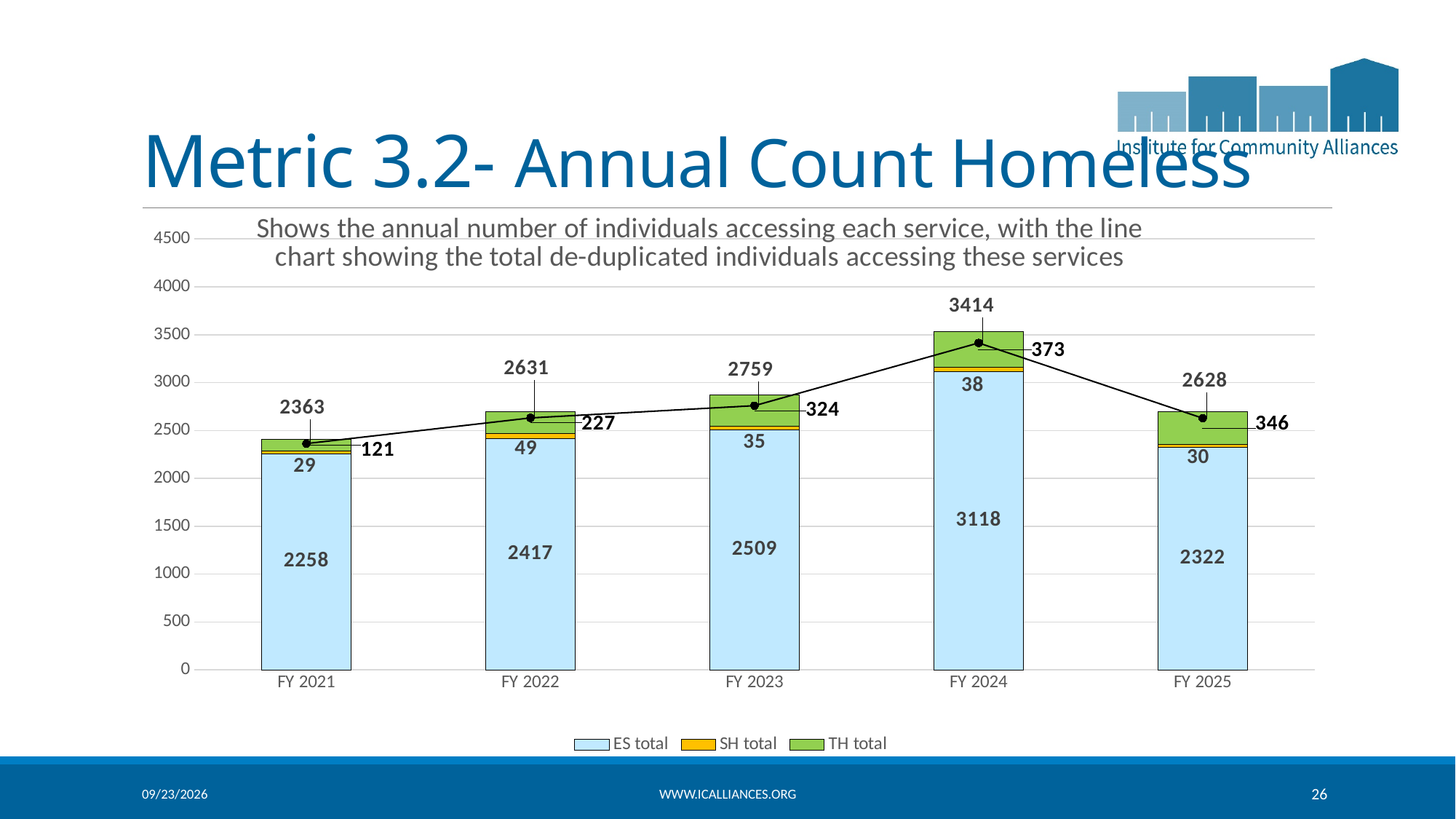
Which fiscal year has the highest ES total? FY 2024 What is the de-duplicated total shown by the line for FY 2025? 2628 Which fiscal year has the lowest TH total? FY 2021 What is the SH total for FY 2022? 49 What is the difference between the ES total for FY 2024 and the ES total for FY 2023? 609 Which is larger, the TH total for FY 2025 or the TH total for FY 2023? FY 2025 What is the ES total for FY 2024? 3118 Does the de-duplicated total line rise or fall from FY 2024 to FY 2025? fall How many series does the legend list? 3 What is the TH total for FY 2023? 324 What is the total of the stacked bar for FY 2021 (ES, SH and TH combined)? 2408 How many fiscal years are shown on the x axis? 5